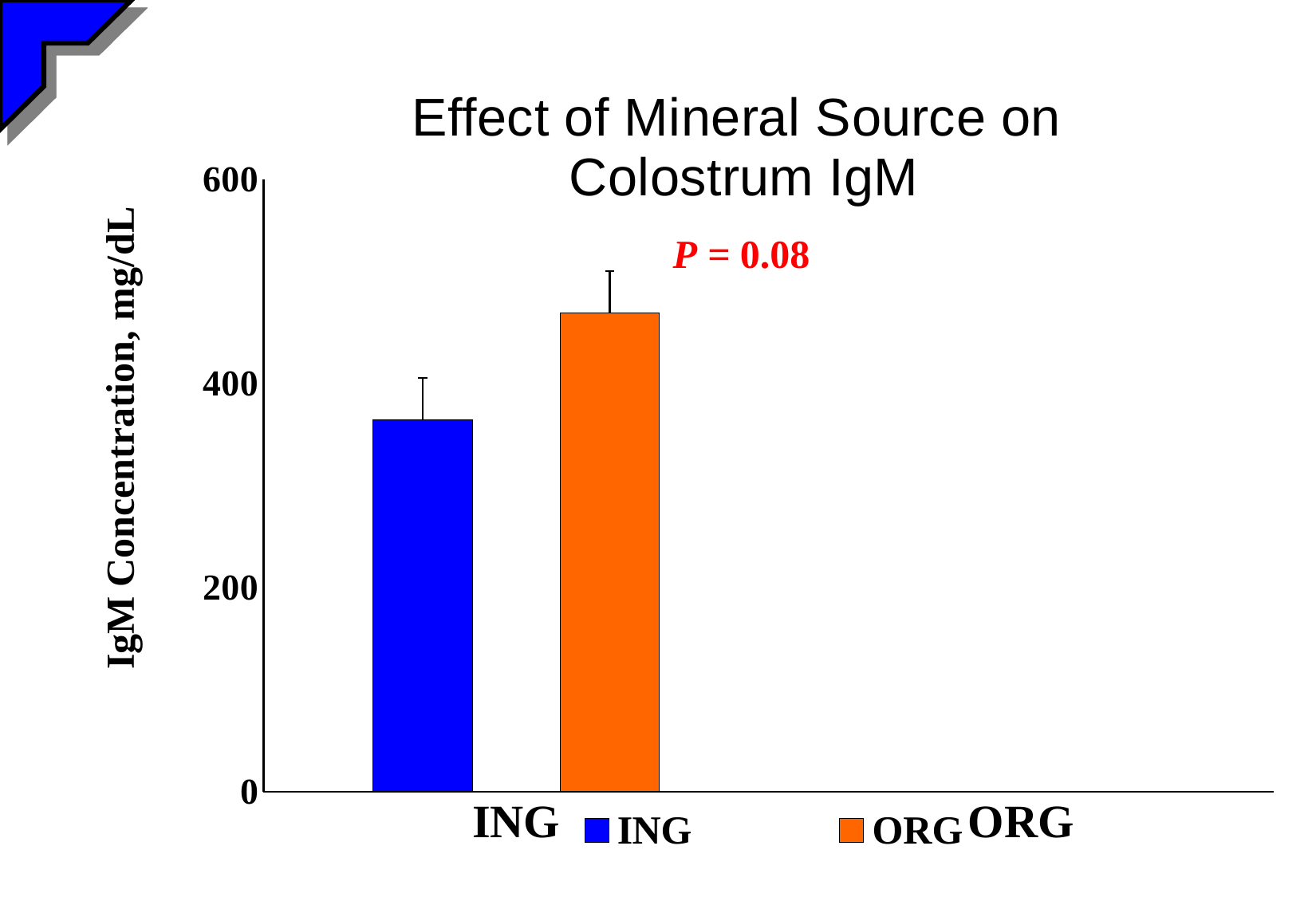
Is the IgM concentration for ING greater or less than 200? greater What P value is shown on the chart? P = 0.08 Is the IgM concentration for ORG greater or less than 600? less How many entries does the legend list? 2 Which category has the highest IgM concentration? ORG What kind of chart is shown on the slide? bar chart Which has a larger IgM concentration, ING or ORG? ORG Which category has the lowest IgM concentration? ING Is the IgM concentration for ING greater or less than 400? less How many categories are plotted on the chart? 2 What is the title of the chart? Effect of Mineral Source on Colostrum IgM